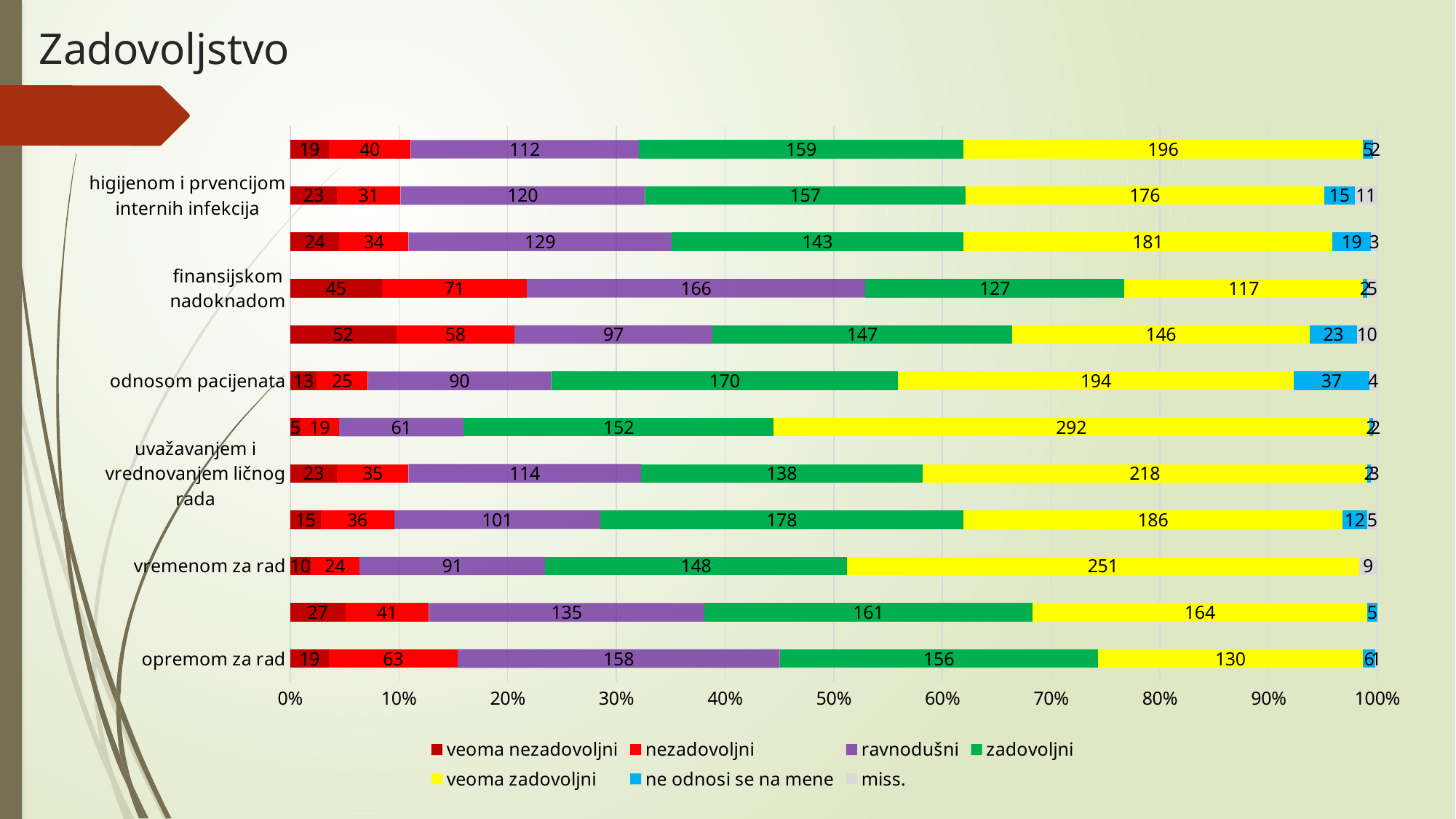
What is the 'veoma zadovoljni' value for 'vremenom za rad'? 251 What is the 'zadovoljni' value for 'opremom za rad'? 156 How many bars are plotted in the chart? 12 For 'opremom za rad', what is the difference between the 'zadovoljni' value and the 'veoma zadovoljni' value? 26 What is the 'ne odnosi se na mene' value for 'odnosom pacijenata'? 37 What is the title of the slide? Zadovoljstvo What kind of chart is shown on the slide? bar chart What is the 'nezadovoljni' value for 'opremom za rad'? 63 How many series does the legend list? 7 What is the 'veoma zadovoljni' value for 'odnosom pacijenata'? 194 Which has the larger 'veoma zadovoljni' value: 'vremenom za rad' or 'opremom za rad'? vremenom za rad What is the 'ravnodušni' value for 'finansijskom nadoknadom'? 166